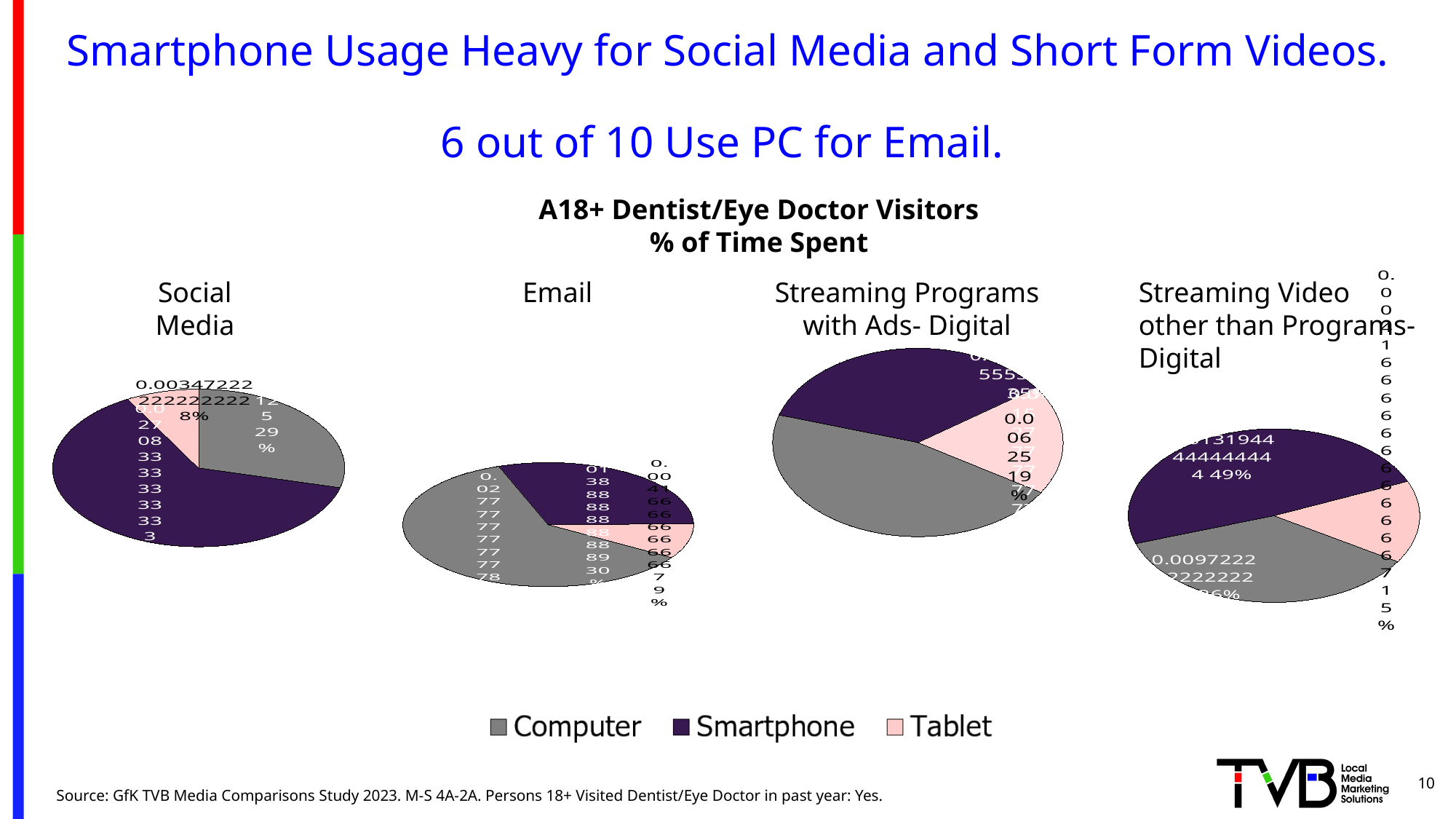
In the Social Media pie chart, how many percentage points larger is the Computer share than the Tablet share? 21 How many pie charts are on the slide? 4 In the Social Media pie chart, which device has the largest share? Smartphone In the Social Media pie chart, what share of time spent is on Computer? 29% What kind of charts are shown on the slide? Pie charts In the Streaming Video other than Programs- Digital pie chart, what share of time spent is on Smartphone? 49% In the Social Media pie chart, what share of time spent is on Tablet? 8% In the Social Media pie chart, which device has the smallest share? Tablet How many series does the legend list? 3 In the Email pie chart, which device has the largest share? Computer In the Social Media pie chart, which is larger: the Computer share or the Tablet share? Computer What are the three series named in the legend? Computer, Smartphone, Tablet